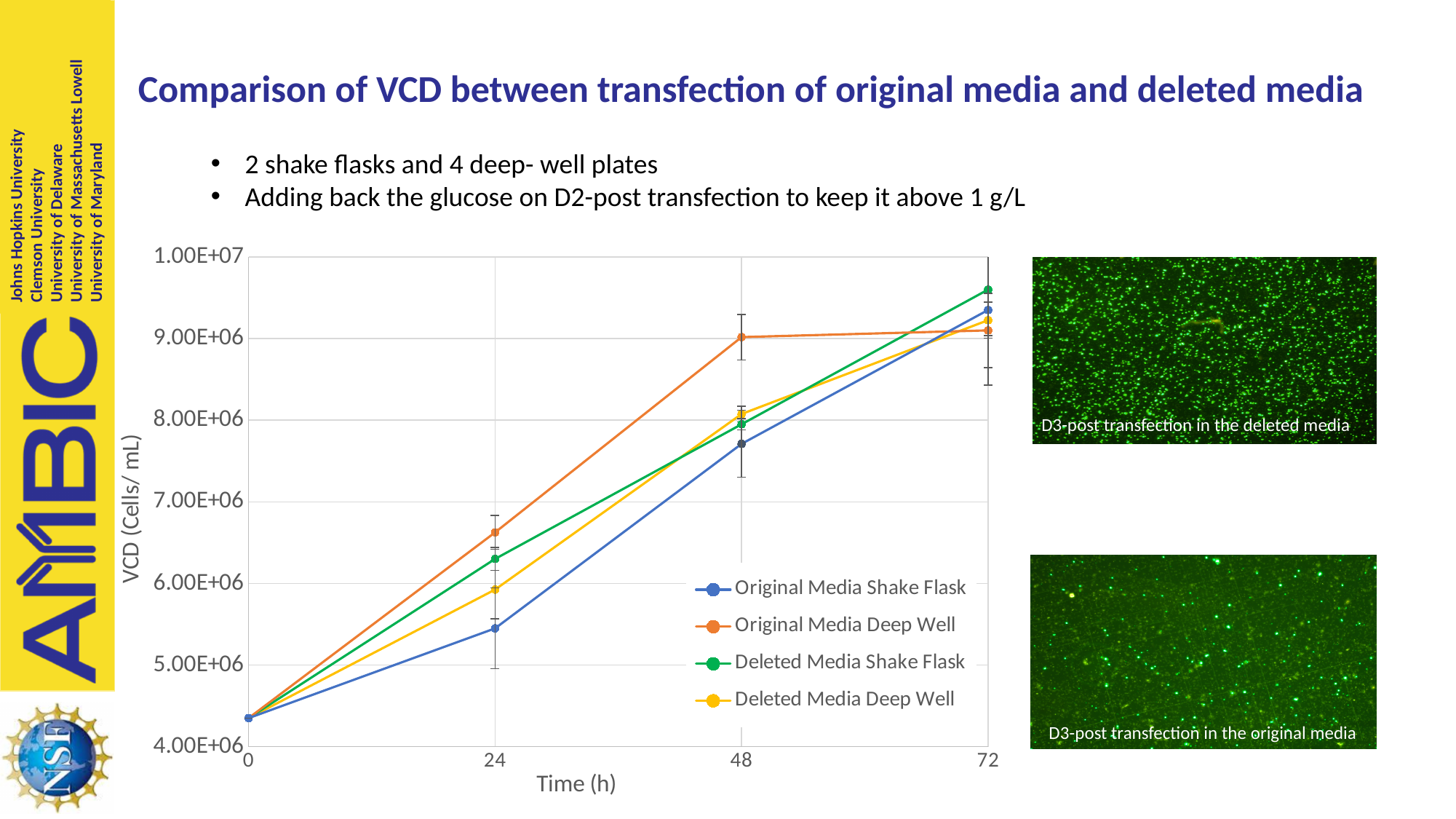
Which series has the lowest VCD at 24 h? Original Media Shake Flask Does the VCD for Original Media Shake Flask rise or fall from 0 h to 72 h? rise Is the value for Original Media Deep Well at 48 h greater or less than 8.00E+06? greater Which series has the highest VCD at 72 h? Deleted Media Shake Flask What kind of chart is shown on the slide? line chart Which series has the highest VCD at 24 h? Original Media Deep Well Is the value for Original Media Shake Flask at 24 h greater or less than 6.00E+06? less How many time points are plotted along the x axis? 4 What is the label of the y axis? VCD (Cells/ mL) At 24 h, which is larger: Deleted Media Shake Flask or Deleted Media Deep Well? Deleted Media Shake Flask How many series does the chart legend list? 4 Which series has the highest VCD at 48 h? Original Media Deep Well